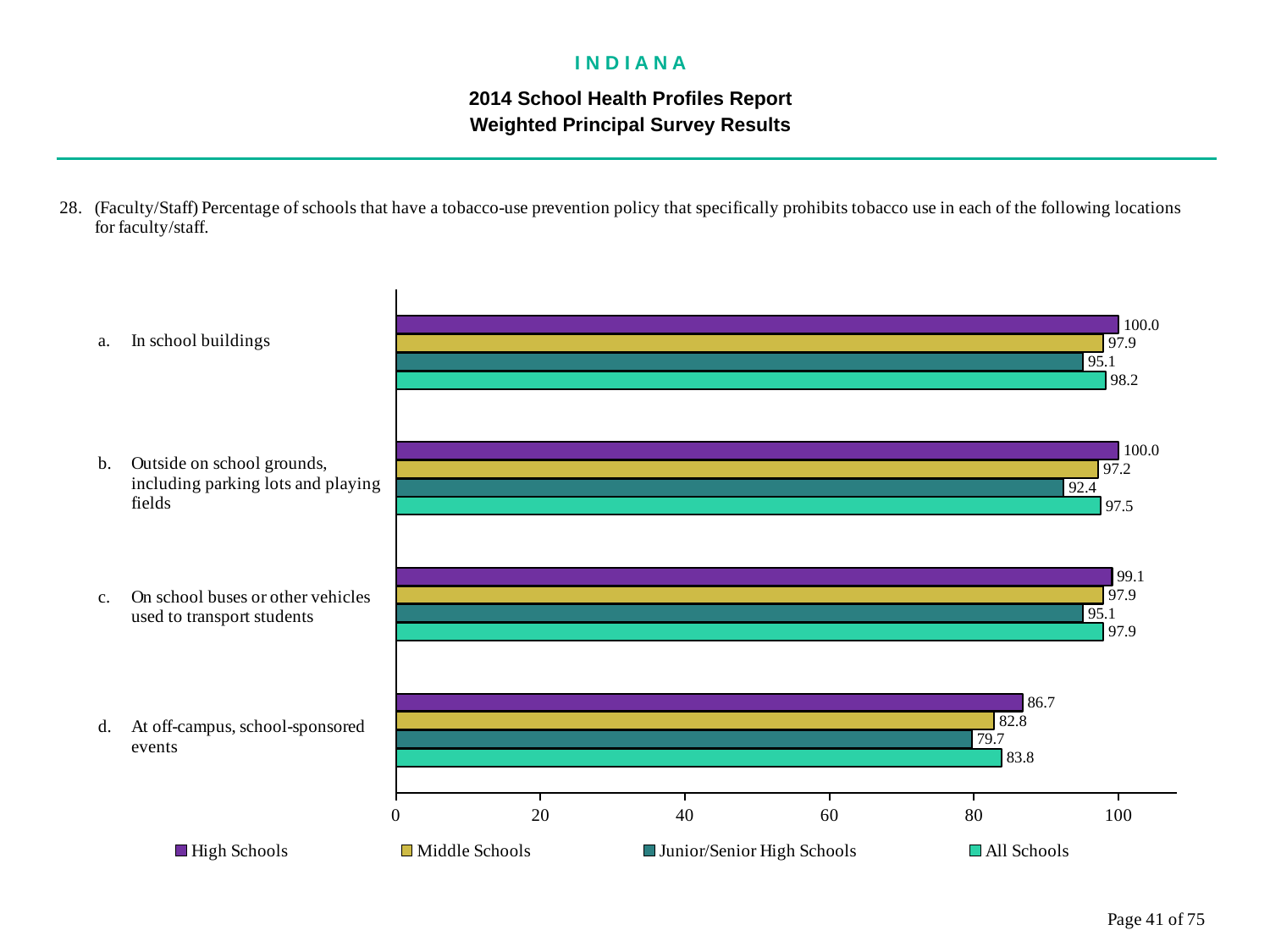
How many locations (categories) are shown in the chart? 4 What kind of chart is shown on the slide? Bar chart Which is larger for 'Outside on school grounds, including parking lots and playing fields': the Middle Schools value or the Junior/Senior High Schools value? Middle Schools What is the value for Middle Schools for 'On school buses or other vehicles used to transport students'? 97.9 What is the value for All Schools for 'At off-campus, school-sponsored events'? 83.8 Is the value for Junior/Senior High Schools for 'At off-campus, school-sponsored events' greater or less than 80? less What is the value for Junior/Senior High Schools for 'Outside on school grounds, including parking lots and playing fields'? 92.4 How many series does the legend list? 4 Which series has the lowest value for 'At off-campus, school-sponsored events'? Junior/Senior High Schools What is the difference between the High Schools and Middle Schools values for 'At off-campus, school-sponsored events'? 3.9 What is the value for High Schools for 'In school buildings'? 100.0 Which location has the lowest value for High Schools? At off-campus, school-sponsored events